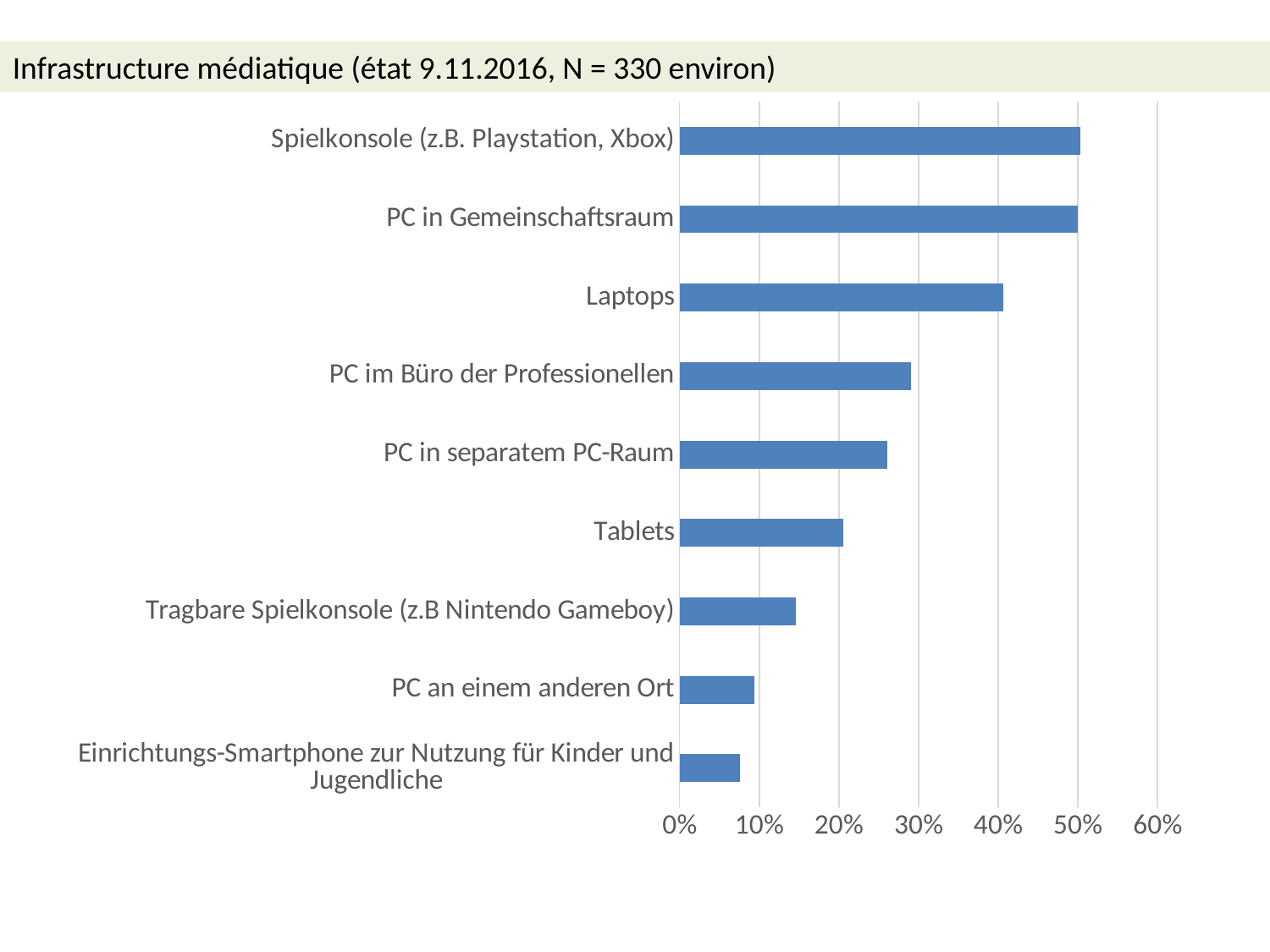
Is the value for PC in separatem PC-Raum greater or less than 30%? less Is the value for Einrichtungs-Smartphone zur Nutzung für Kinder und Jugendliche greater or less than 10%? less Is the value for Tragbare Spielkonsole (z.B Nintendo Gameboy) greater or less than 20%? less What is the highest value shown on the horizontal axis? 60% How many categories are plotted in the chart? 9 What is the title of the chart? Infrastructure médiatique (état 9.11.2016, N = 330 environ) Which is larger, the value for Laptops or the value for Tablets? Laptops What kind of chart is shown on the slide? bar chart Which is larger, the value for PC im Büro der Professionellen or the value for Tragbare Spielkonsole (z.B Nintendo Gameboy)? PC im Büro der Professionellen Which category has the lowest value? Einrichtungs-Smartphone zur Nutzung für Kinder und Jugendliche